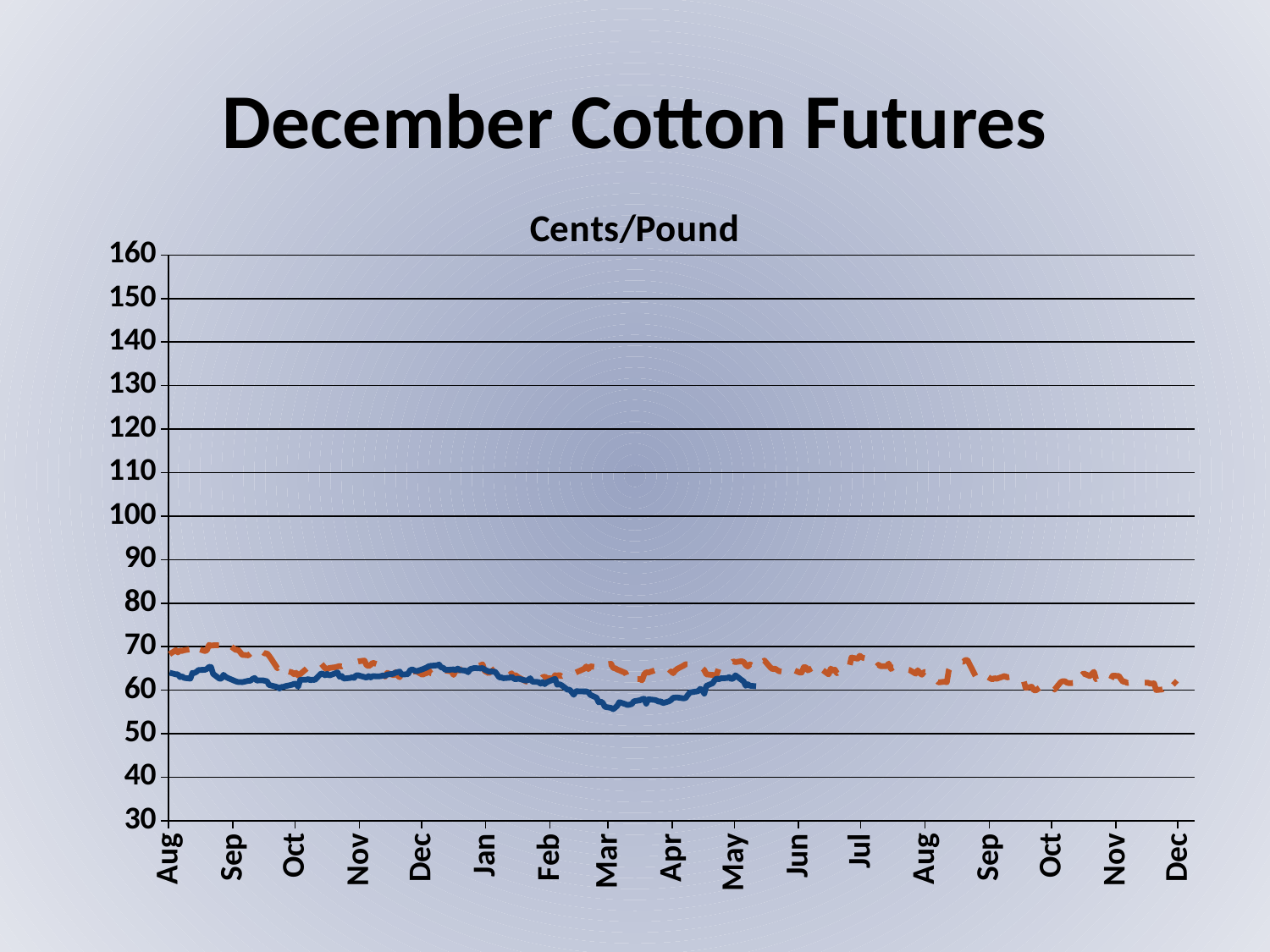
How many month labels are shown along the x axis? 17 Is the value of the solid blue line at Mar greater or less than 60? less Around which month does the solid blue line reach its lowest point? Mar What kind of chart is shown on the slide? line chart What is the highest value shown on the y axis? 160 At the first Sep, which line is higher, the solid blue line or the dashed orange line? the dashed orange line Does the solid blue line rise or fall between Feb and Mar? fall What is the title printed above the chart's plot area? Cents/Pound Is the value of the dashed orange line at the first Sep greater or less than 60? greater Is the value of the dashed orange line at Jul greater or less than 80? less At Mar, which line is higher, the solid blue line or the dashed orange line? the dashed orange line How many lines are plotted on the chart? 2